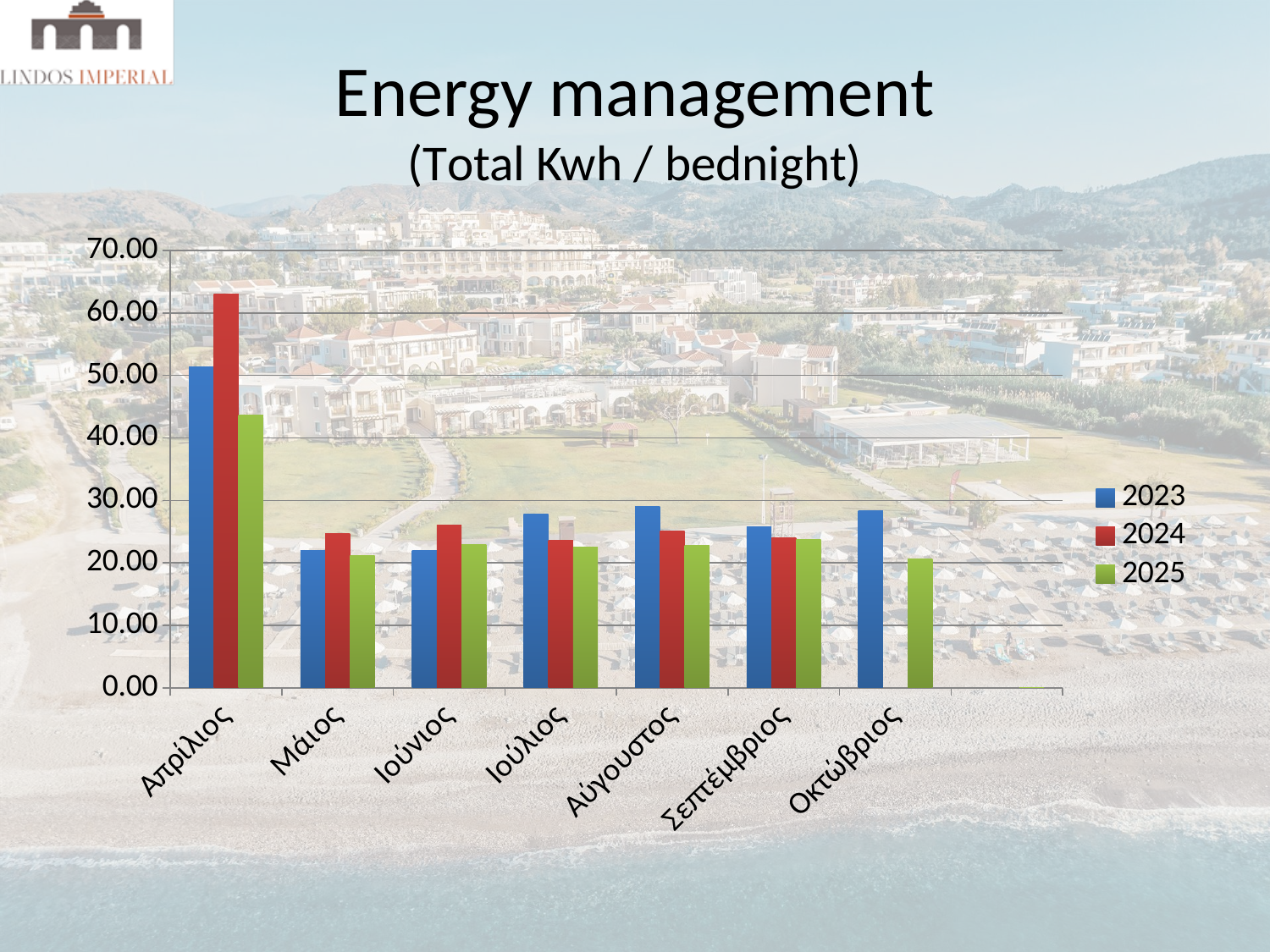
For Ιούλιος, which series has the larger value, 2023 or 2024? 2023 Is the 2025 value for Απρίλιος greater or less than 40.00? greater Is the 2023 value for Αύγουστος greater or less than 20.00? greater How many months are shown on the x axis? 7 What is the subtitle of the chart shown under 'Energy management'? (Total Kwh / bednight) For Απρίλιος, which series has the larger value, 2023 or 2024? 2024 Which month has the highest value for the 2024 series? Απρίλιος Which series has no bar for Οκτώβριος? 2024 How many series does the legend list? 3 Is the 2025 value for Οκτώβριος greater or less than 30.00? less What kind of chart is shown on the slide? bar chart